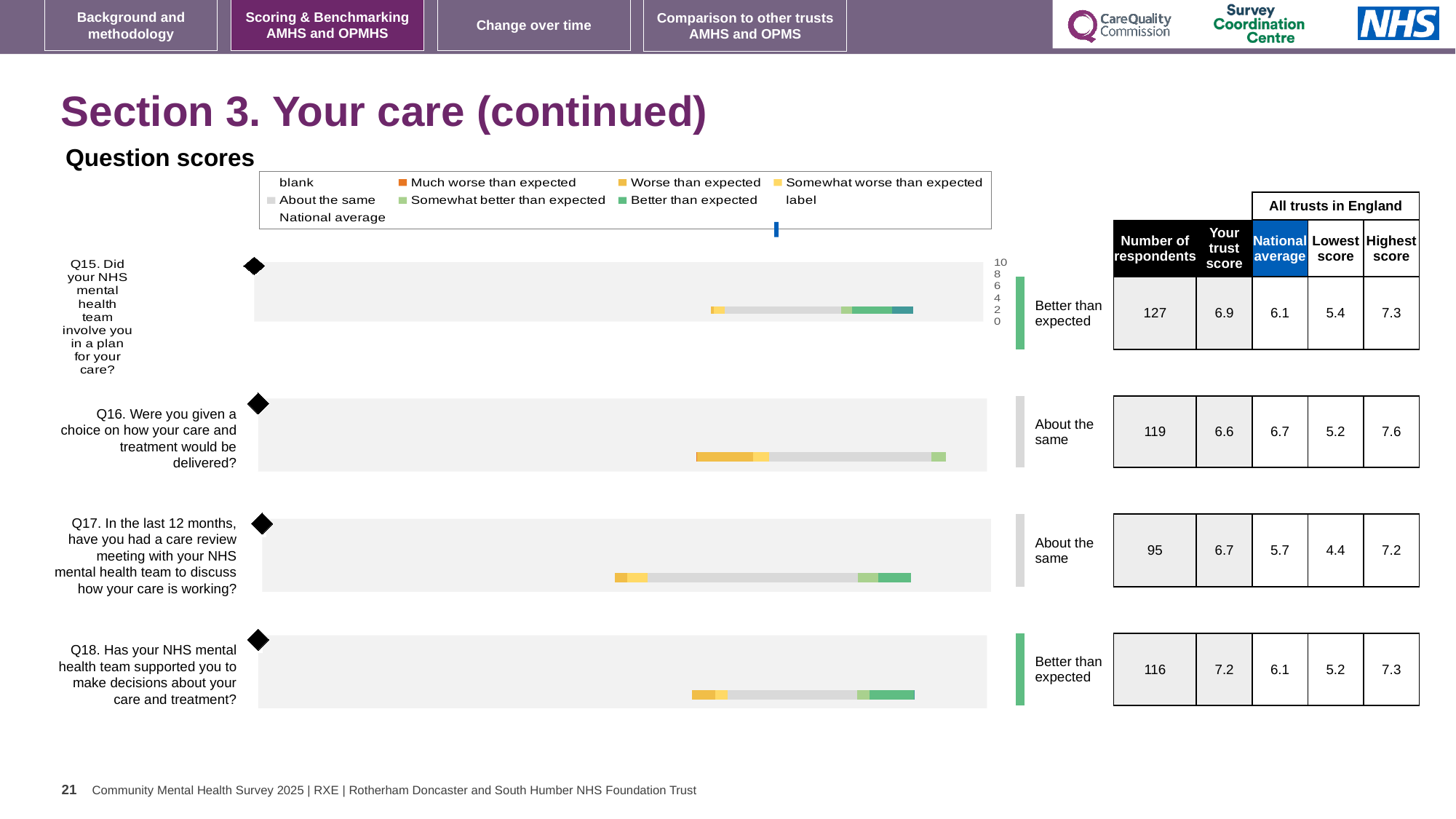
For Q16, which is larger: the trust score or the national average? National average Which question has the lowest number of respondents? Q17 What benchmark category is shown for Q15? Better than expected What kind of chart is used to show the question scores for Q15 to Q18? bar chart What benchmark category is shown for Q17? About the same Which question has the highest trust score? Q18 What is the trust score for Q15 (Did your NHS mental health team involve you in a plan for your care?)? 6.9 What is the national average score for Q17 (care review meeting in the last 12 months)? 5.7 What is the number of respondents for Q16 (Were you given a choice on how your care and treatment would be delivered?)? 119 What is the highest score among all trusts in England for Q18 (supported you to make decisions about your care and treatment)? 7.3 How many questions (Q15 to Q18) are plotted on the slide? 4 What is the difference between the trust score and the national average for Q18? 1.1